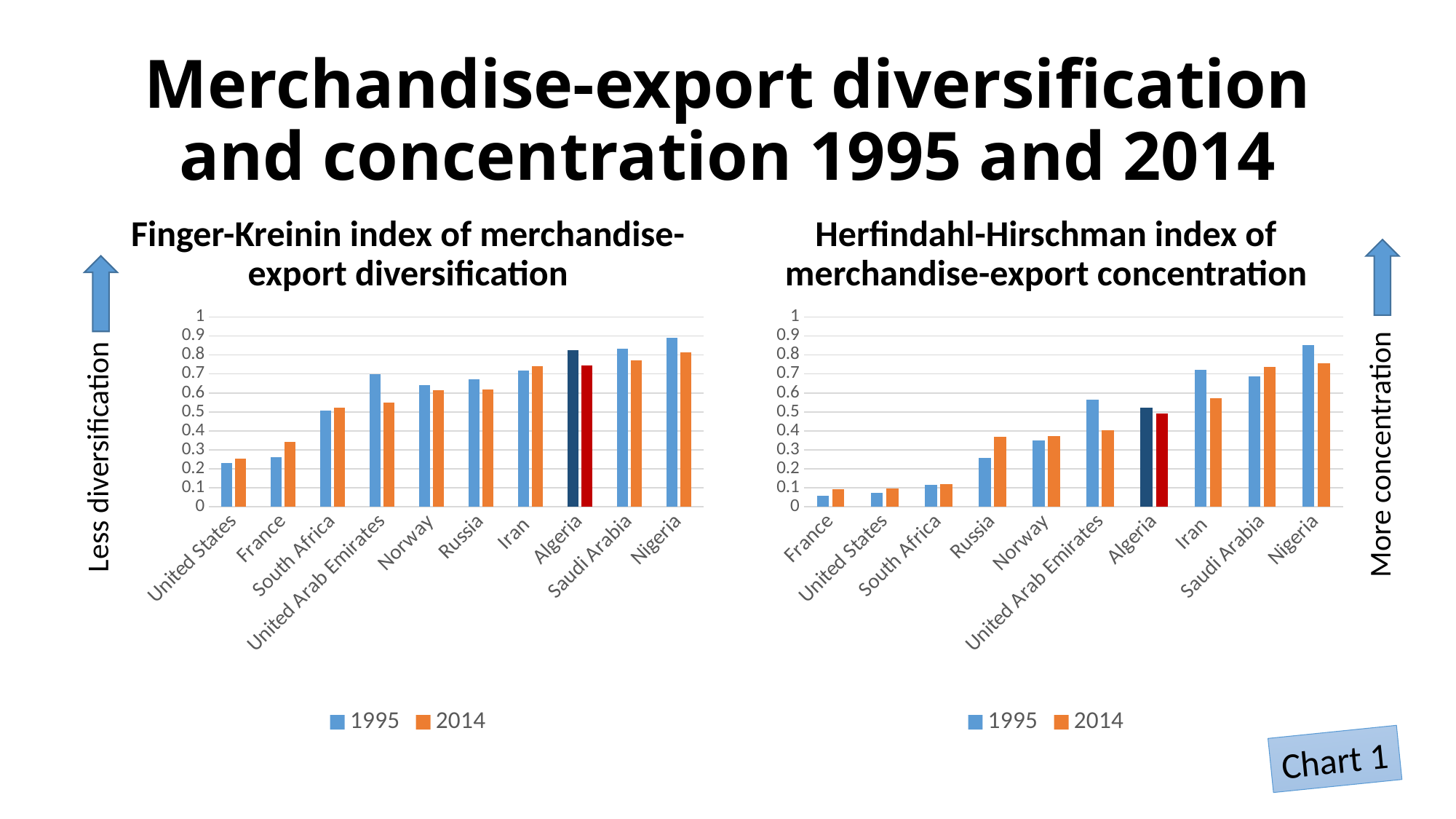
Which series is shown in orange on the Herfindahl-Hirschman index of merchandise-export concentration chart? 2014 How many countries are shown on the Finger-Kreinin index of merchandise-export diversification chart? 10 On the Finger-Kreinin index of merchandise-export diversification chart, which is larger for United Arab Emirates: the 1995 value or the 2014 value? 1995 How many series does the legend of the Herfindahl-Hirschman index of merchandise-export concentration chart list? 2 On the Finger-Kreinin index of merchandise-export diversification chart, which country has the highest 1995 value? Nigeria What type of chart is the Finger-Kreinin index of merchandise-export diversification chart? bar chart On the Herfindahl-Hirschman index of merchandise-export concentration chart, is the 1995 value for Russia greater or less than 0.3? less On the Herfindahl-Hirschman index of merchandise-export concentration chart, which is larger for Iran: the 1995 value or the 2014 value? 1995 On the Herfindahl-Hirschman index of merchandise-export concentration chart, which country has the highest 1995 value? Nigeria On the Finger-Kreinin index of merchandise-export diversification chart, which country has the lowest 1995 value? United States On the Finger-Kreinin index of merchandise-export diversification chart, is the 1995 value for United Arab Emirates greater or less than 0.6? greater On the Herfindahl-Hirschman index of merchandise-export concentration chart, is the 2014 value for United Arab Emirates greater or less than 0.3? greater